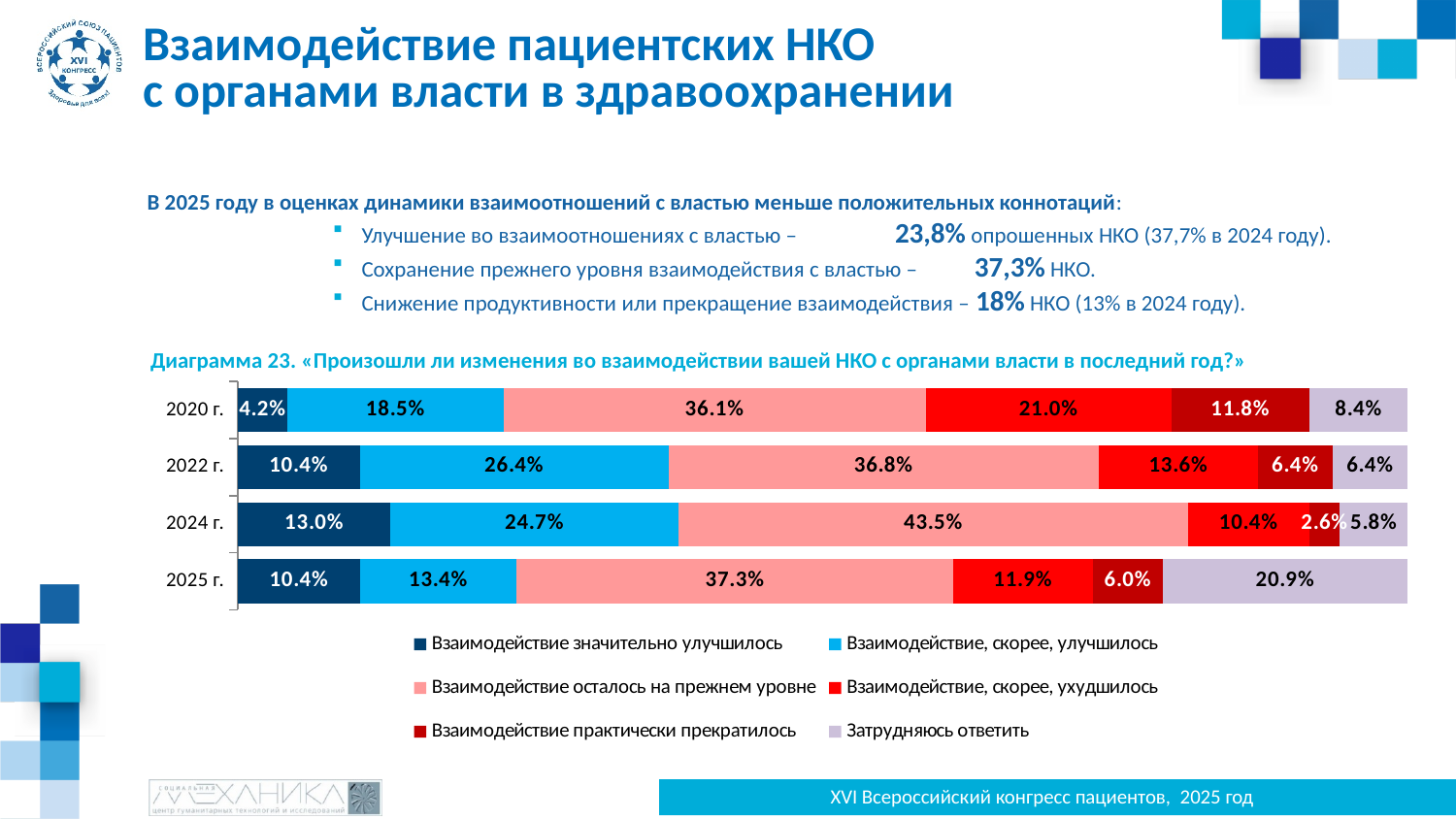
In the chart 'Диаграмма 23', which year has the larger value for 'Затрудняюсь ответить': 2022 г. or 2025 г.? 2025 г. In the chart 'Диаграмма 23', which year has the lowest value for 'Взаимодействие значительно улучшилось'? 2020 г. How many series does the legend of the chart 'Диаграмма 23' list? 6 In the chart 'Диаграмма 23', which series is shown in light pink? Взаимодействие осталось на прежнем уровне In the chart 'Диаграмма 23', does the value for 'Взаимодействие осталось на прежнем уровне' rise or fall from 2020 г. to 2024 г.? Rise What kind of chart is 'Диаграмма 23'? Stacked bar chart In the chart 'Диаграмма 23', what is the value for 'Взаимодействие практически прекратилось' in 2024 г.? 2.6% How many years (categories) are shown in the chart 'Диаграмма 23'? 4 In the chart 'Диаграмма 23', what is the value for 'Взаимодействие осталось на прежнем уровне' in 2025 г.? 37.3% In the chart 'Диаграмма 23', which year has the highest value for 'Взаимодействие осталось на прежнем уровне'? 2024 г. In the chart 'Диаграмма 23', what is the value for 'Взаимодействие, скорее, ухудшилось' in 2020 г.? 21.0% In the chart 'Диаграмма 23', what is the difference between the 2024 г. and 2025 г. values for 'Взаимодействие, скорее, улучшилось'? 11.3 percentage points